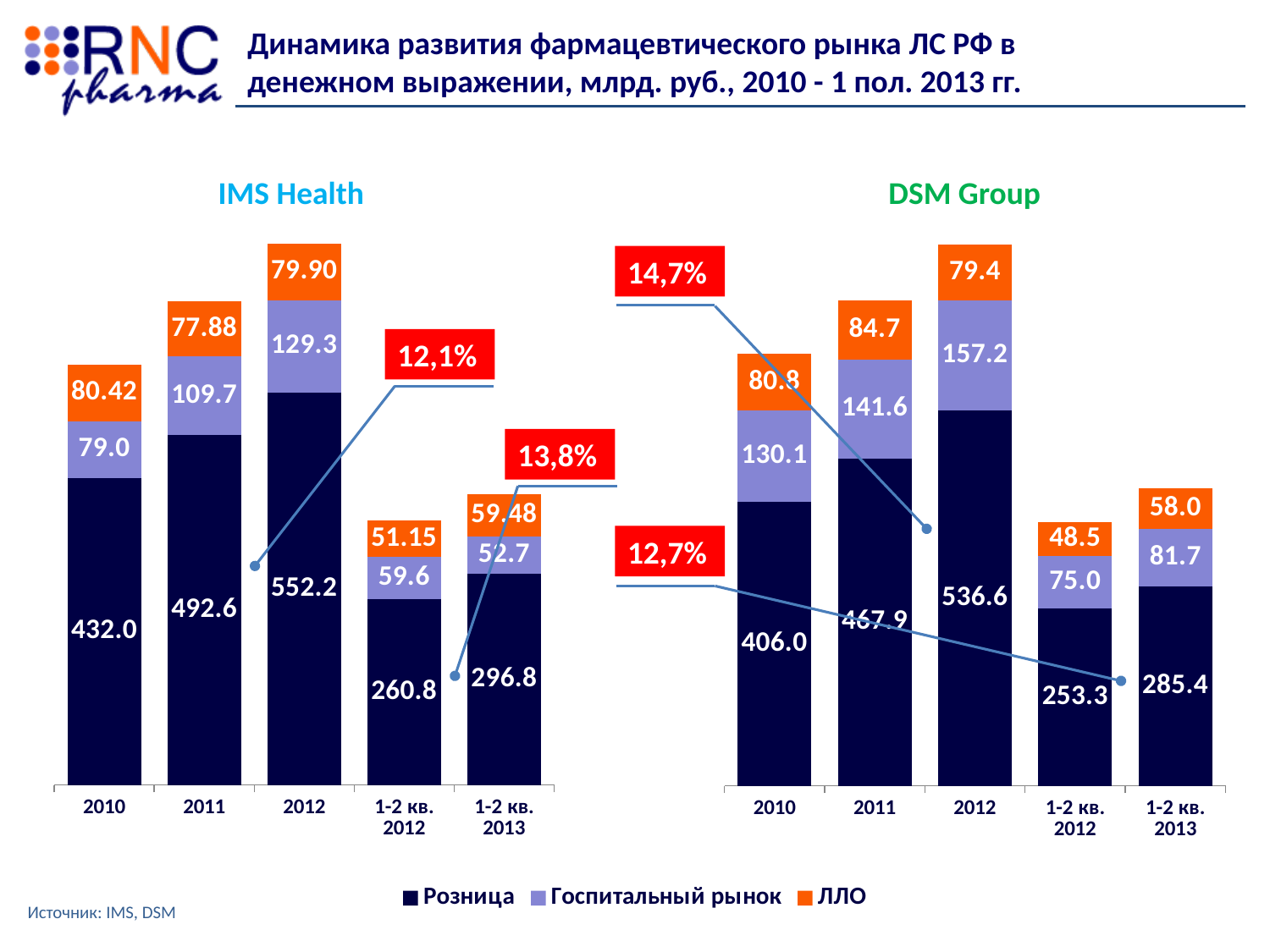
In the IMS Health chart, what is the Розница value for 2012? 552.2 In the IMS Health chart, what is the ЛЛО value for 2010? 80.42 In the DSM Group chart, what is the ЛЛО value for 1-2 кв. 2013? 58.0 In the DSM Group chart, what is the Госпитальный рынок value for 2012? 157.2 In the DSM Group chart, what is the total of the stacked bar for 1-2 кв. 2013? 425.1 In the DSM Group chart, which period has the lowest Розница value? 1-2 кв. 2012 In the IMS Health chart, which year has the highest Розница value? 2012 What kind of chart is the IMS Health chart? Stacked bar chart In the DSM Group chart, which is larger: the Госпитальный рынок value for 2011 or for 2012? 2012 In the IMS Health chart, what is the total of the stacked bar for 2012? 761.4 How many series does the legend list? 3 In the IMS Health chart, what is the difference between the Розница values for 2012 and 2011? 59.6